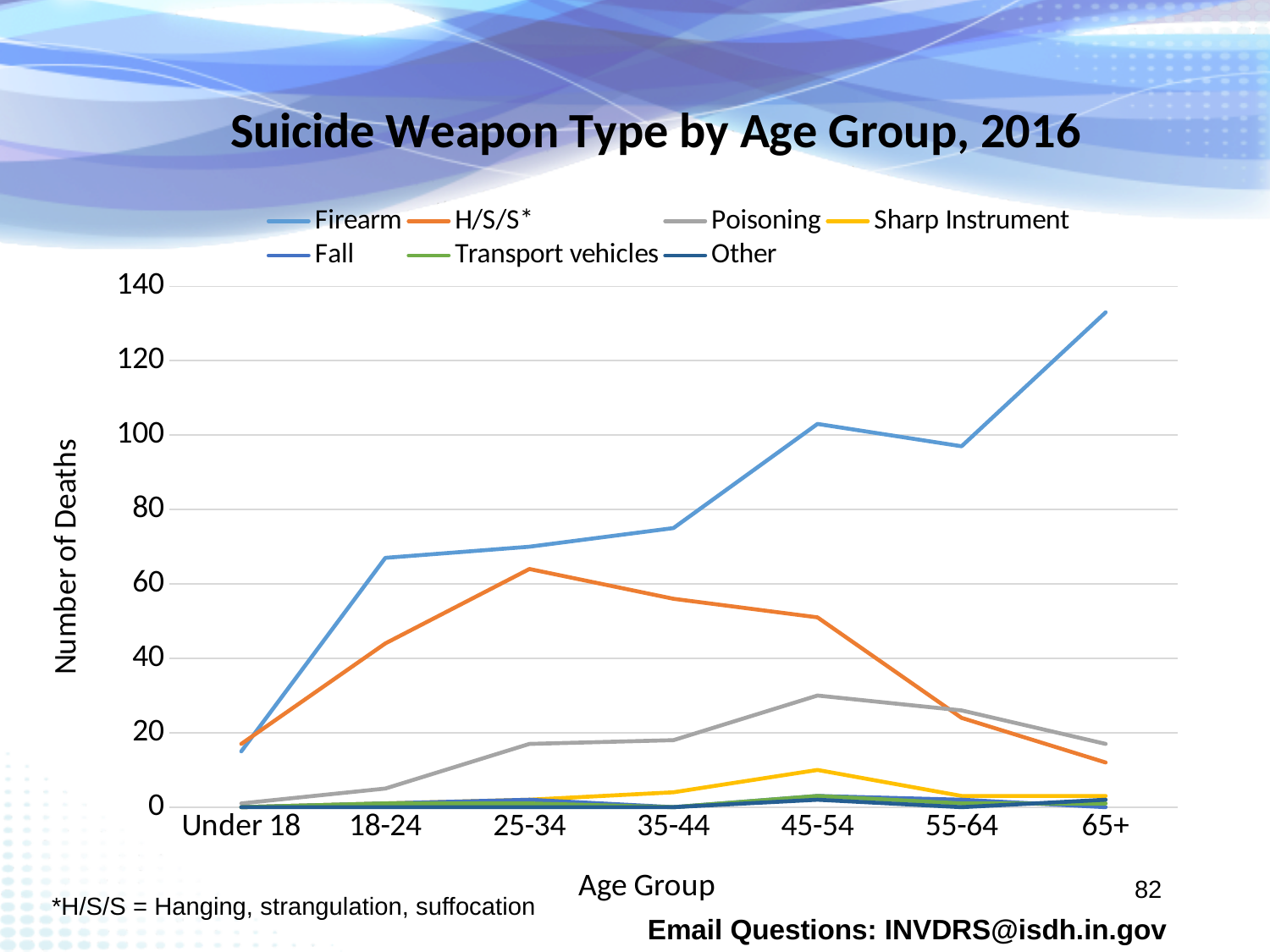
Which age group has the highest number of H/S/S* deaths? 25-34 What does the footnote say H/S/S stands for? Hanging, strangulation, suffocation For the 65+ age group, which is larger: Firearm or H/S/S*? Firearm How many series does the legend list? 7 Is the Firearm value for the 65+ age group greater or less than 120? greater What kind of chart is shown on the slide? line chart Is the H/S/S* value for the 25-34 age group greater or less than 80? less How many age groups are shown on the x axis? 7 Which age group has the lowest number of Firearm deaths? Under 18 Is the Poisoning value for the 45-54 age group greater or less than 20? greater Which age group has the highest number of Poisoning deaths? 45-54 Which age group has the highest number of Firearm deaths? 65+